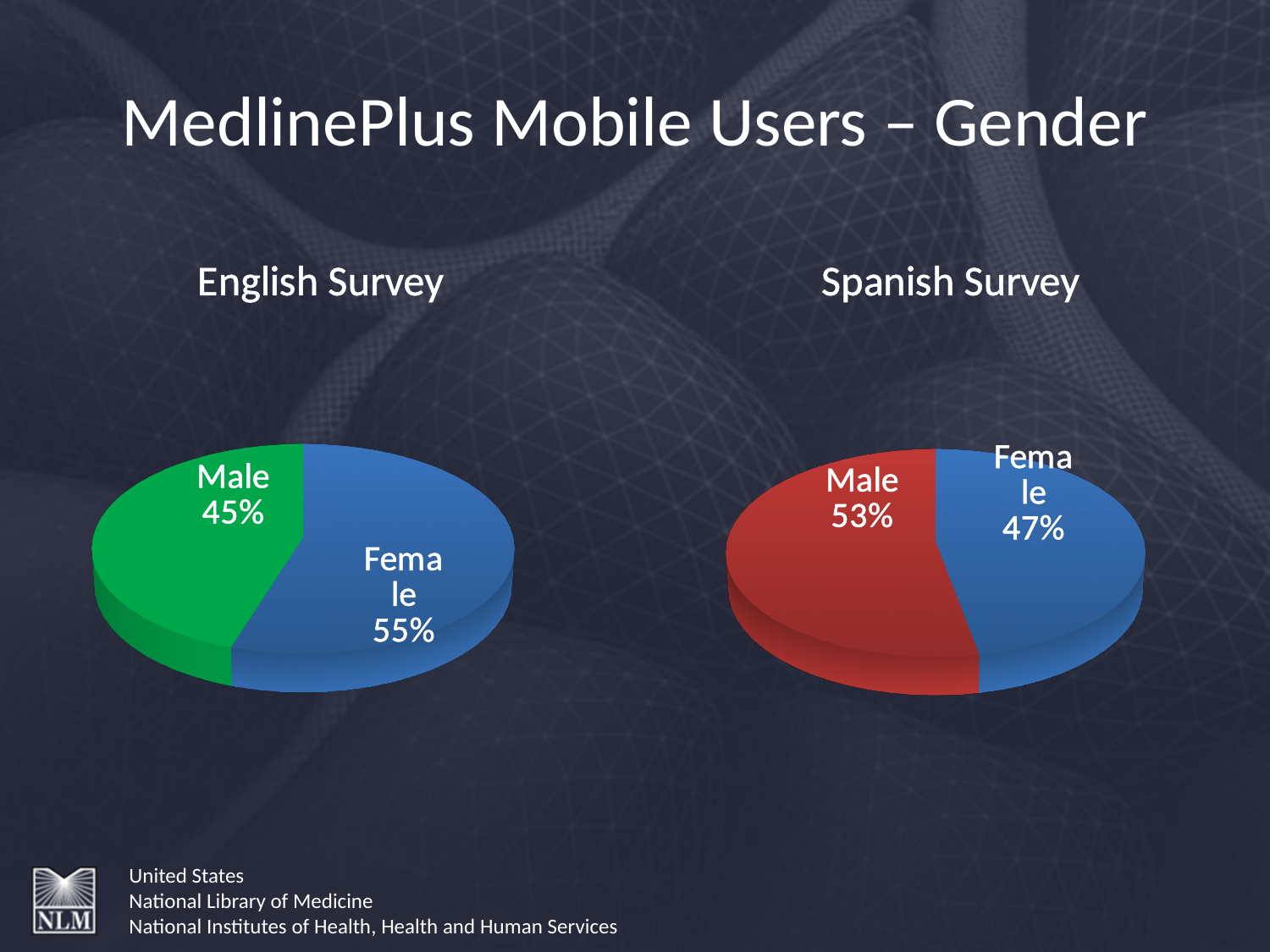
How many slices does the Spanish Survey pie chart have? 2 In the English Survey chart, what percentage of users are Female? 55% In the Spanish Survey chart, which gender has the smaller share? Female In the Spanish Survey chart, what is the difference between the Male and Female shares? 6% In the Spanish Survey chart, what percentage of users are Female? 47% What is the title of the slide containing the two charts? MedlinePlus Mobile Users – Gender In the English Survey chart, which gender has the larger share? Female Is the Male share larger in the English Survey chart or the Spanish Survey chart? Spanish Survey In the English Survey chart, what percentage of users are Male? 45% In the Spanish Survey chart, what percentage of users are Male? 53% In the English Survey chart, what is the difference between the Female and Male shares? 10% What type of chart is the English Survey chart? Pie chart